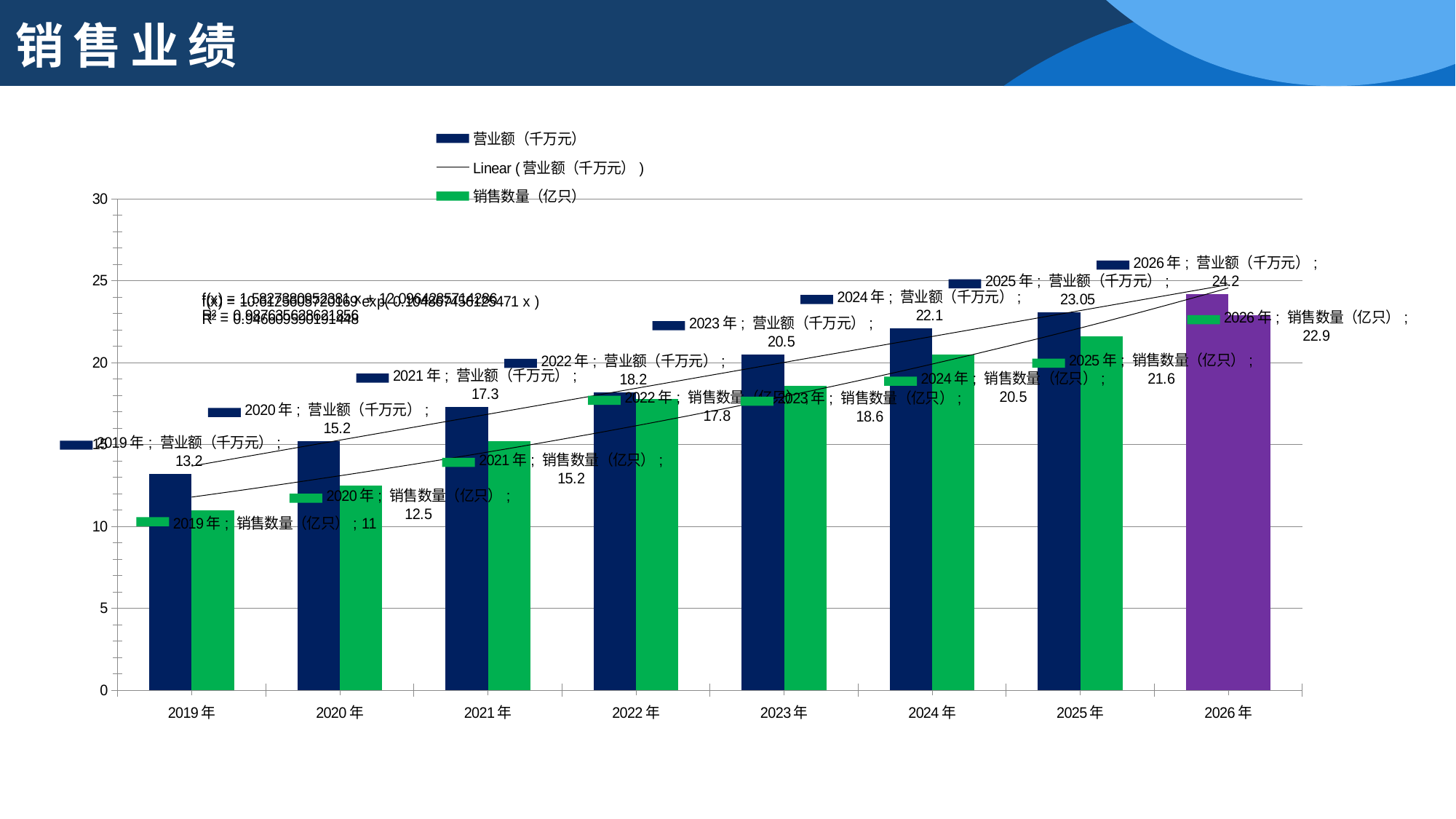
Which is larger: the 销售数量（亿只） value for 2022 年 or for 2020 年? 2022 年 How many years are shown on the x axis? 8 What is the difference between the 营业额（千万元） values for 2024 年 and 2019 年? 8.9 What is the 营业额（千万元） value for 2023 年? 20.5 How many entries does the legend list? 3 Do the 营业额（千万元） values rise or fall from 2019 年 to 2026 年? rise Which year has the lowest 销售数量（亿只） value? 2019 年 What is the 营业额（千万元） value for 2025 年? 23.05 Is the 营业额（千万元） value for 2021 年 greater or less than 15? greater What kind of chart is shown on the slide? bar chart What is the 销售数量（亿只） value for 2021 年? 15.2 Which year has the highest 营业额（千万元） value? 2026 年